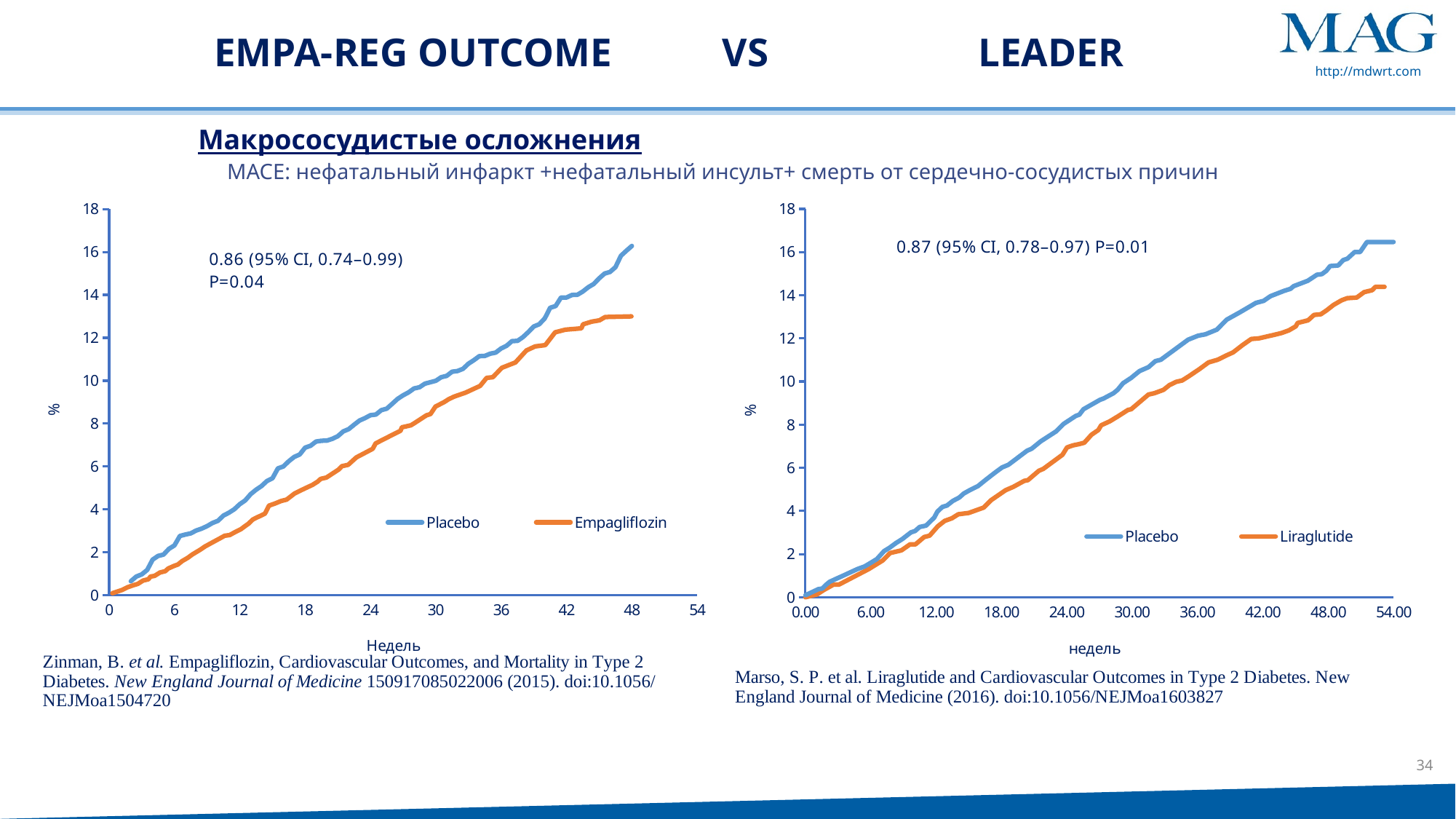
In the right chart (LEADER), which series is higher at week 54, Placebo or Liraglutide? Placebo In the right chart (LEADER), is the Liraglutide value at week 54 greater or less than 16? less In the left chart (EMPA-REG OUTCOME), is the Placebo value at week 48 greater or less than 14? greater What kind of chart is the right chart (LEADER)? line chart In the left chart (EMPA-REG OUTCOME), do the values rise or fall as the weeks increase? rise In the right chart (LEADER), does the Liraglutide line rise or fall along the x axis? rise What kind of chart is the left chart (EMPA-REG OUTCOME)? line chart Which two series are listed in the legend of the right chart (LEADER)? Placebo and Liraglutide How many series does the legend of the left chart (EMPA-REG OUTCOME) list? 2 In the left chart (EMPA-REG OUTCOME), is the Empagliflozin value at week 48 greater or less than 14? less What hazard ratio annotation is printed on the right chart (LEADER)? 0.87 (95% CI, 0.78–0.97) P=0.01 In the left chart (EMPA-REG OUTCOME), which series is higher at week 48, Placebo or Empagliflozin? Placebo